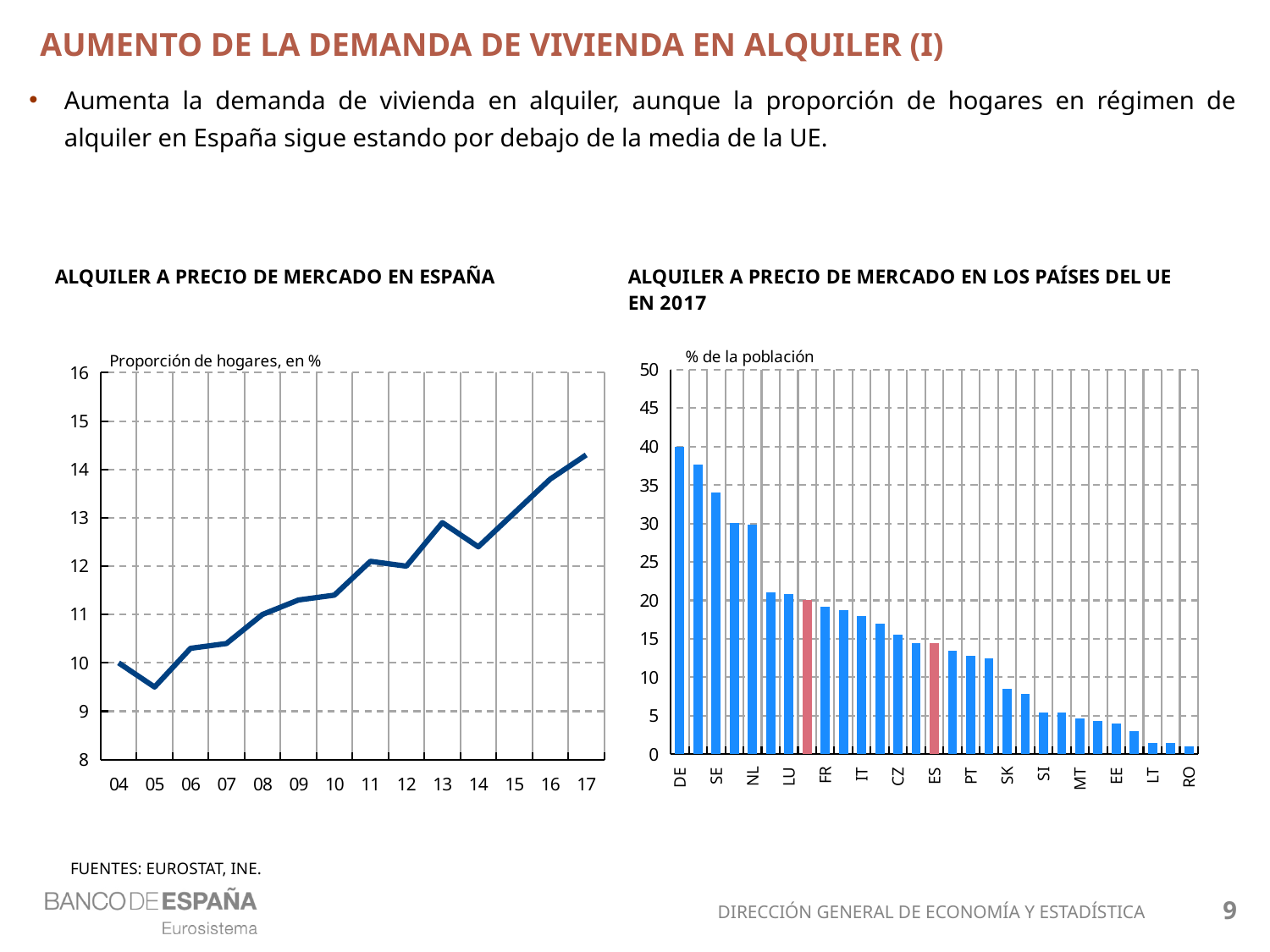
In the right chart, 'ALQUILER A PRECIO DE MERCADO EN LOS PAÍSES DEL UE EN 2017', which is larger, the value for ES or the value for PT? ES In the right chart, 'ALQUILER A PRECIO DE MERCADO EN LOS PAÍSES DEL UE EN 2017', is the value for SE greater or less than 30? greater What is the y-axis unit label shown on the left chart, 'ALQUILER A PRECIO DE MERCADO EN ESPAÑA'? Proporción de hogares, en % In the left chart, 'ALQUILER A PRECIO DE MERCADO EN ESPAÑA', is the value for 05 greater or less than 10? less What kind of chart is the right chart, 'ALQUILER A PRECIO DE MERCADO EN LOS PAÍSES DEL UE EN 2017'? bar chart What kind of chart is the left chart, 'ALQUILER A PRECIO DE MERCADO EN ESPAÑA'? line chart In the left chart, 'ALQUILER A PRECIO DE MERCADO EN ESPAÑA', is the value for 17 greater or less than 14? greater In the left chart, 'ALQUILER A PRECIO DE MERCADO EN ESPAÑA', do the values generally rise or fall from 04 to 17? rise In the left chart, 'ALQUILER A PRECIO DE MERCADO EN ESPAÑA', which year has the highest value? 17 In the left chart, 'ALQUILER A PRECIO DE MERCADO EN ESPAÑA', which year has the lowest value? 05 In the right chart, 'ALQUILER A PRECIO DE MERCADO EN LOS PAÍSES DEL UE EN 2017', which country has the lowest value? RO In the right chart, 'ALQUILER A PRECIO DE MERCADO EN LOS PAÍSES DEL UE EN 2017', which country has the highest value? DE